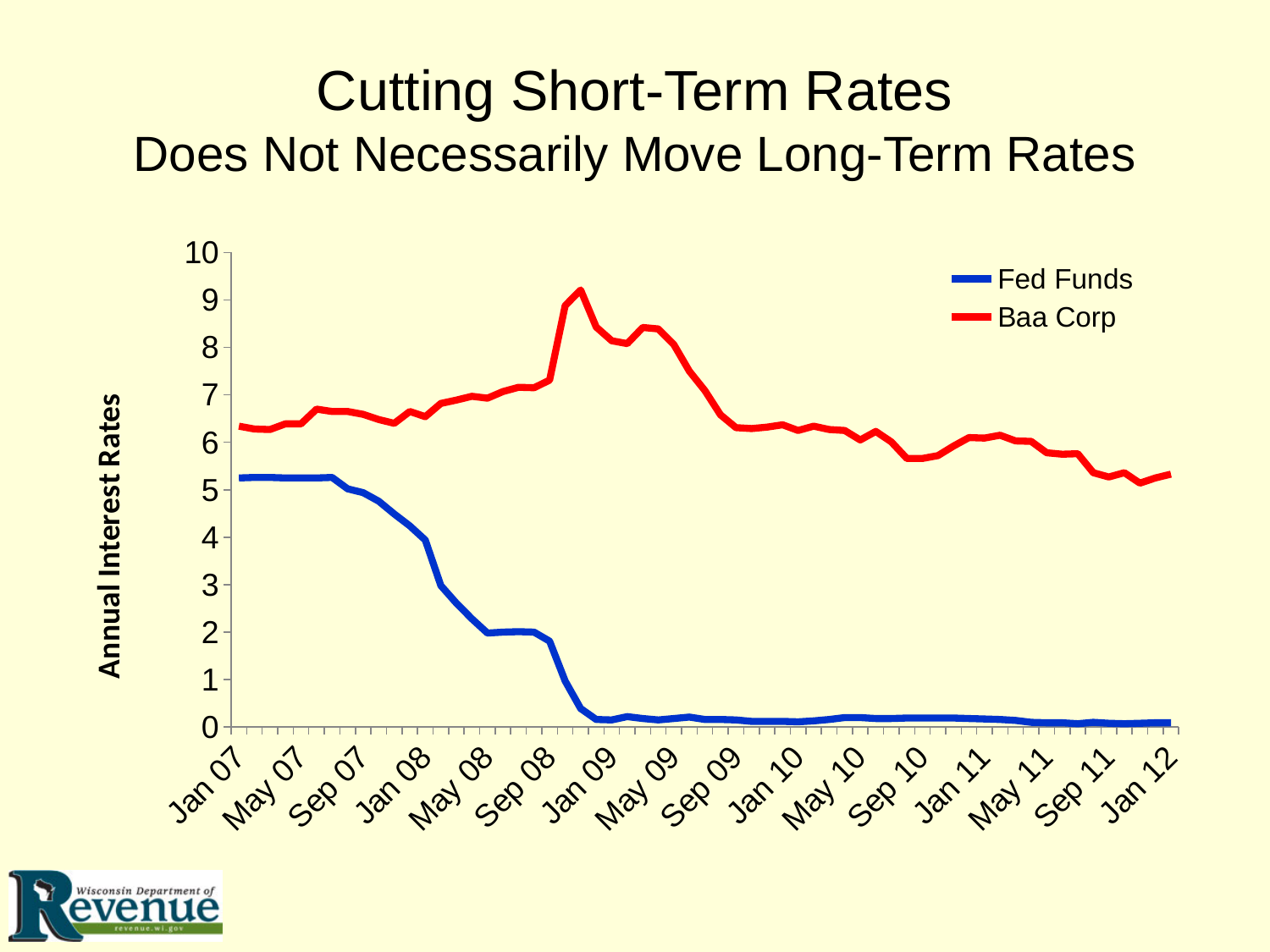
Is the Fed Funds value at Jan 07 greater or less than 4? greater How many series does the legend list? 2 Is the Baa Corp value at Jan 12 greater or less than 6? less What kind of chart is shown on the slide? Line chart How many date labels are shown on the x axis? 16 Is the highest Baa Corp value on the chart greater or less than 8? greater Does the Fed Funds line rise or fall from Jan 07 to Jan 12? Fall Which series is drawn in red? Baa Corp At Jan 09, which series has the larger value, Fed Funds or Baa Corp? Baa Corp What is the title of the vertical axis? Annual Interest Rates